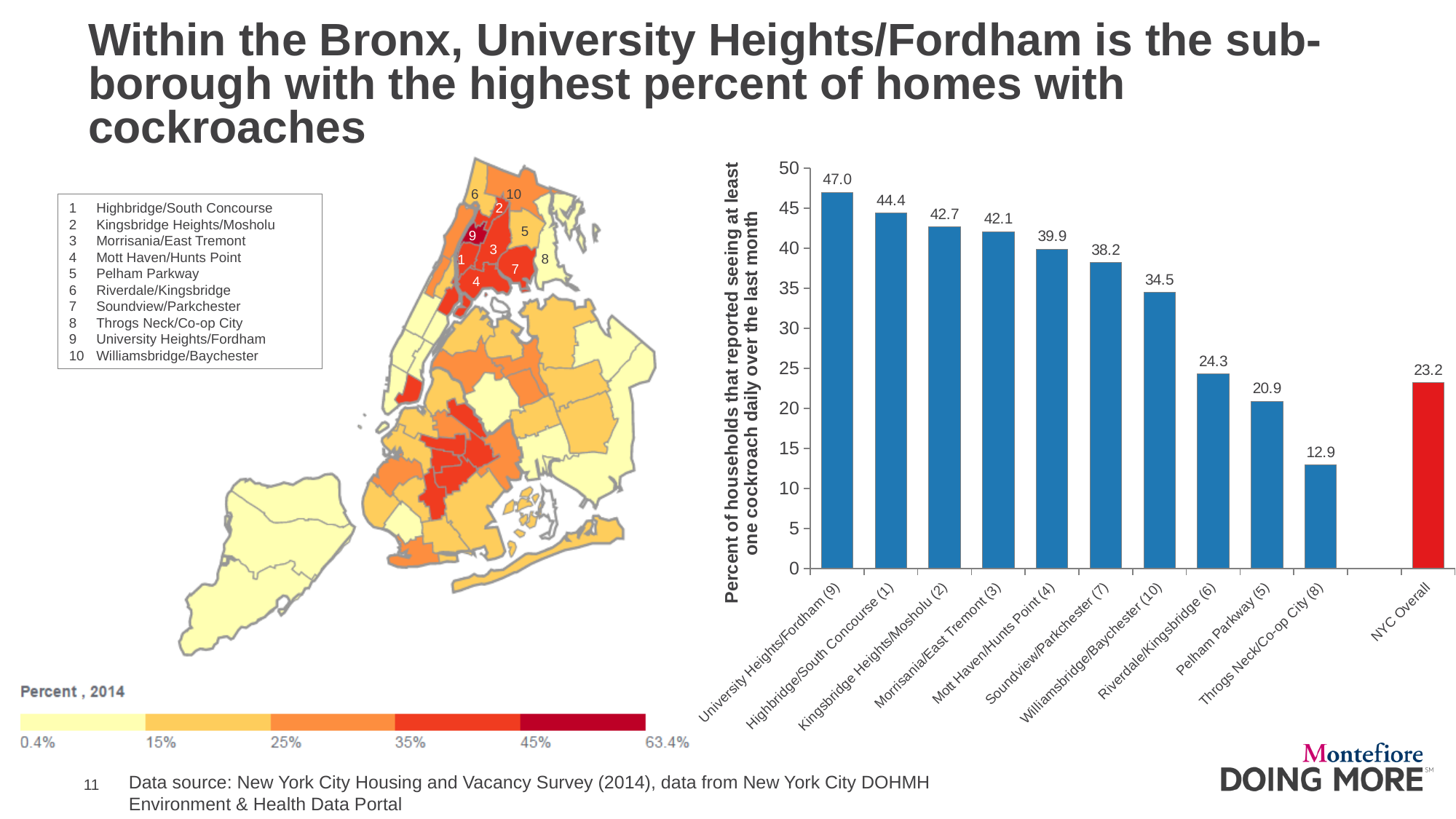
Is the value for Mott Haven/Hunts Point (4) in the bar chart greater or less than 35? greater What is the value for Soundview/Parkchester (7) in the bar chart? 38.2 In the bar chart, which is larger: the value for Pelham Parkway (5) or the value for NYC Overall? NYC Overall Which category has the lowest value in the bar chart? Throgs Neck/Co-op City (8) How many bars are shown in the bar chart? 11 Which category has the highest value in the bar chart? University Heights/Fordham (9) What is the difference between the values for Williamsbridge/Baychester (10) and Riverdale/Kingsbridge (6) in the bar chart? 10.2 What is the difference between the values for University Heights/Fordham (9) and NYC Overall in the bar chart? 23.8 What is the value for University Heights/Fordham (9) in the bar chart? 47.0 What kind of chart is shown on the right side of the slide? bar chart What is the value for NYC Overall in the bar chart? 23.2 Which bar in the bar chart is coloured red rather than blue? NYC Overall